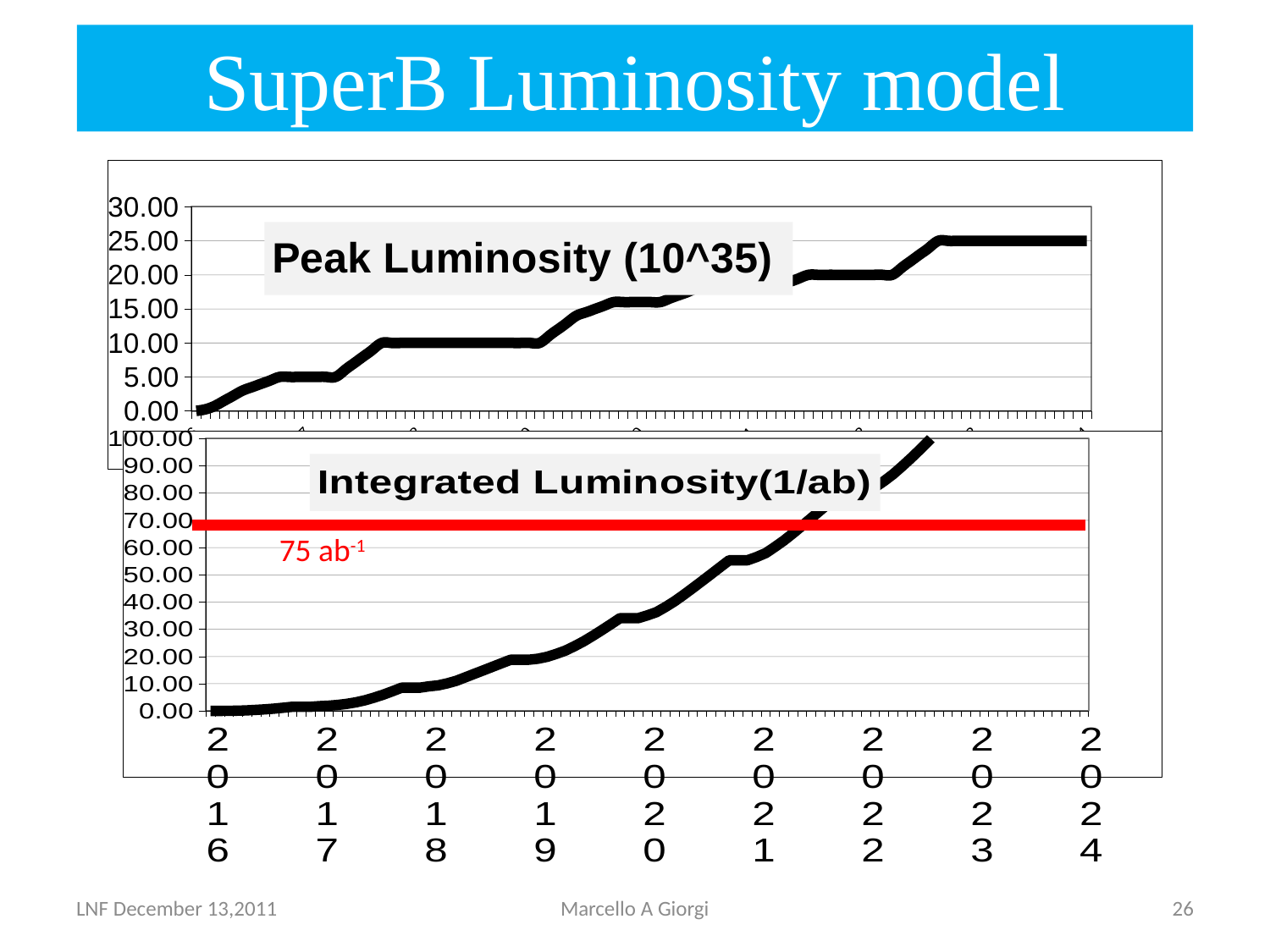
In the Integrated Luminosity(1/ab) chart, which year has the larger value, 2019 or 2023? 2023 In the Peak Luminosity (10^35) chart, do the values generally rise or fall along the x axis? rise In the Integrated Luminosity(1/ab) chart, do the values rise or fall from 2016 to 2024? rise In the Integrated Luminosity(1/ab) chart, which year has the lowest value? 2016 What kind of chart is the Peak Luminosity (10^35) chart? line chart In the Integrated Luminosity(1/ab) chart, is the value for 2020 greater or less than 30.00? greater In the Peak Luminosity (10^35) chart, is the value for 2019 greater or less than 15.00? less What kind of chart is the Integrated Luminosity(1/ab) chart? line chart In the Peak Luminosity (10^35) chart, is the value for 2024 greater or less than 20.00? greater In the Integrated Luminosity(1/ab) chart, which year has the highest value? 2024 What label is written next to the red horizontal line in the Integrated Luminosity(1/ab) chart? 75 ab-1